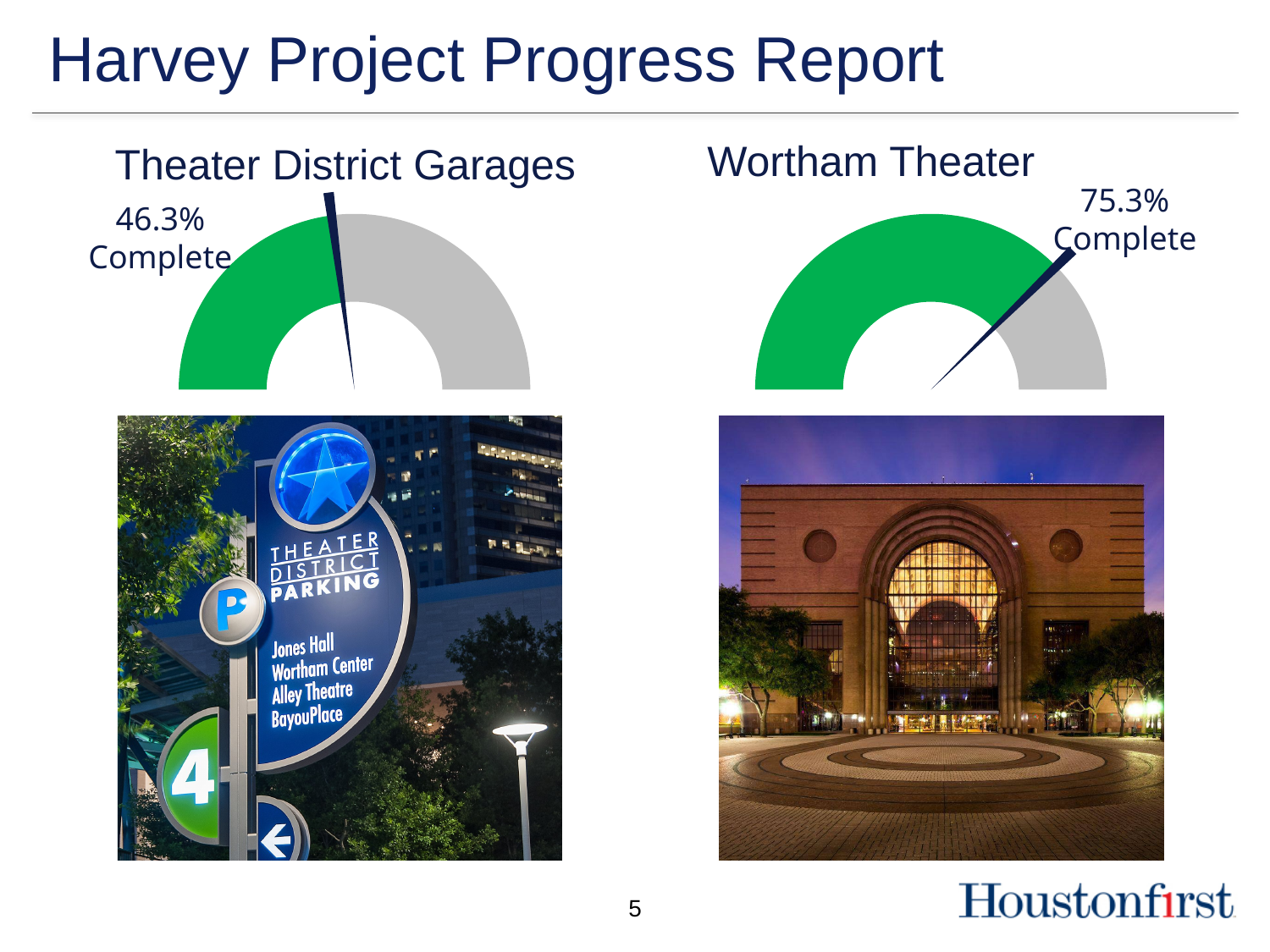
Which of the two projects on the slide has the highest percentage complete? Wortham Theater What kind of chart is used to show the progress of each project on the slide? Gauge chart Which of the two projects on the slide has the lowest percentage complete? Theater District Garages Which project shows the higher percentage complete, Theater District Garages or Wortham Theater? Wortham Theater What is the difference in percentage complete between the Wortham Theater gauge and the Theater District Garages gauge? 29.0% On the Theater District Garages gauge, is the percentage complete greater or less than 50%? less What is the title of the gauge chart on the left side of the slide? Theater District Garages On the Wortham Theater gauge, is the percentage complete greater or less than 50%? greater On the Wortham Theater gauge, what colour represents the completed portion? Green On the Wortham Theater gauge, what percentage complete is shown? 75.3% On the Theater District Garages gauge, what percentage complete is shown? 46.3% How many gauge charts are shown on the slide? 2